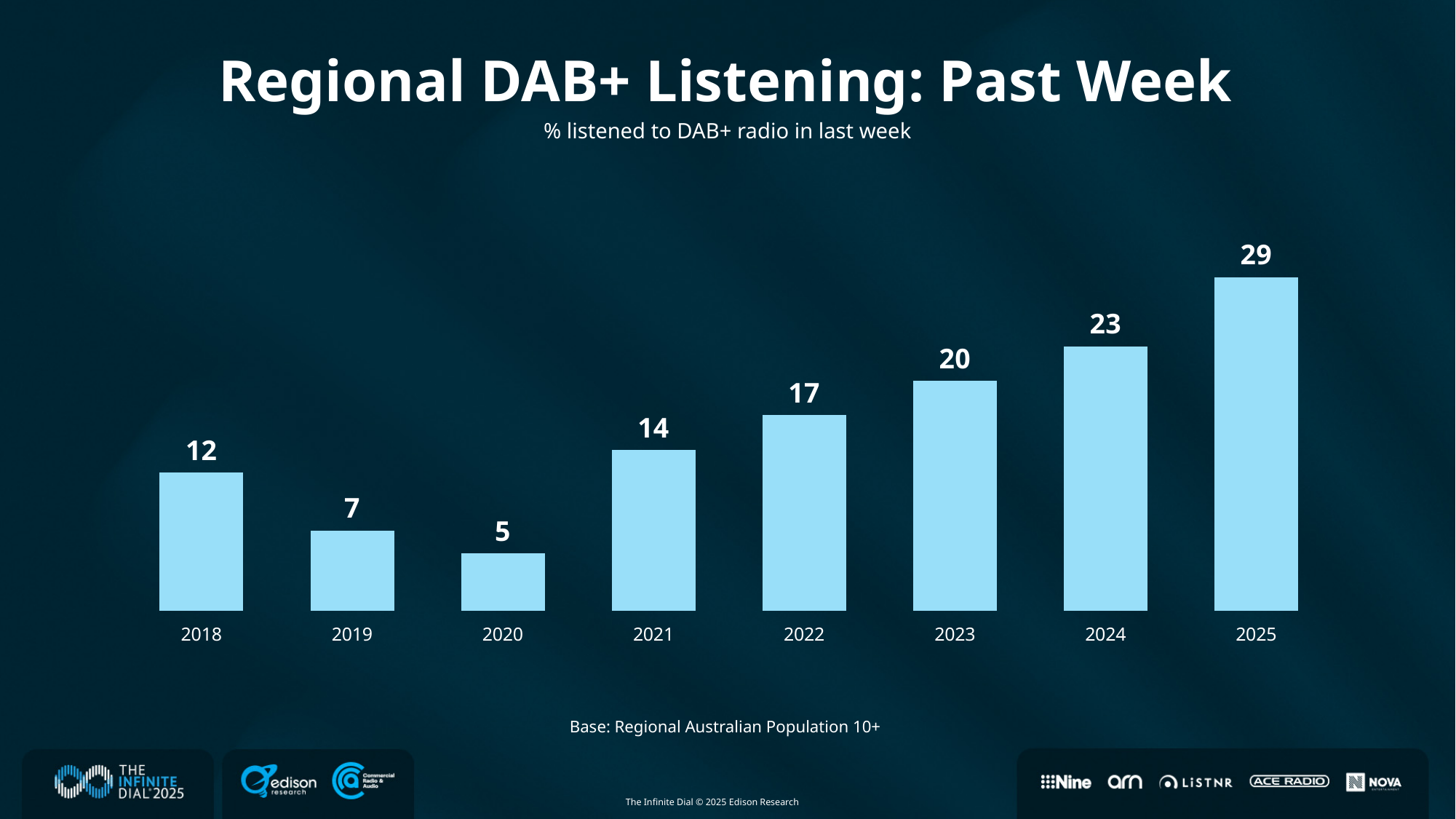
What kind of chart is shown on the slide? bar chart Which year has the highest value? 2025 Which is larger, the value for 2018 or the value for 2019? 2018 What is the difference between the values for 2025 and 2018? 17 What is the title of the chart? Regional DAB+ Listening: Past Week What is the difference between the values for 2024 and 2023? 3 How many years are shown on the chart? 8 What is the value for 2025? 29 What is the value for 2022? 17 Which year has the lowest value? 2020 Do the values rise or fall from 2020 to 2025? rise What is the value for 2020? 5